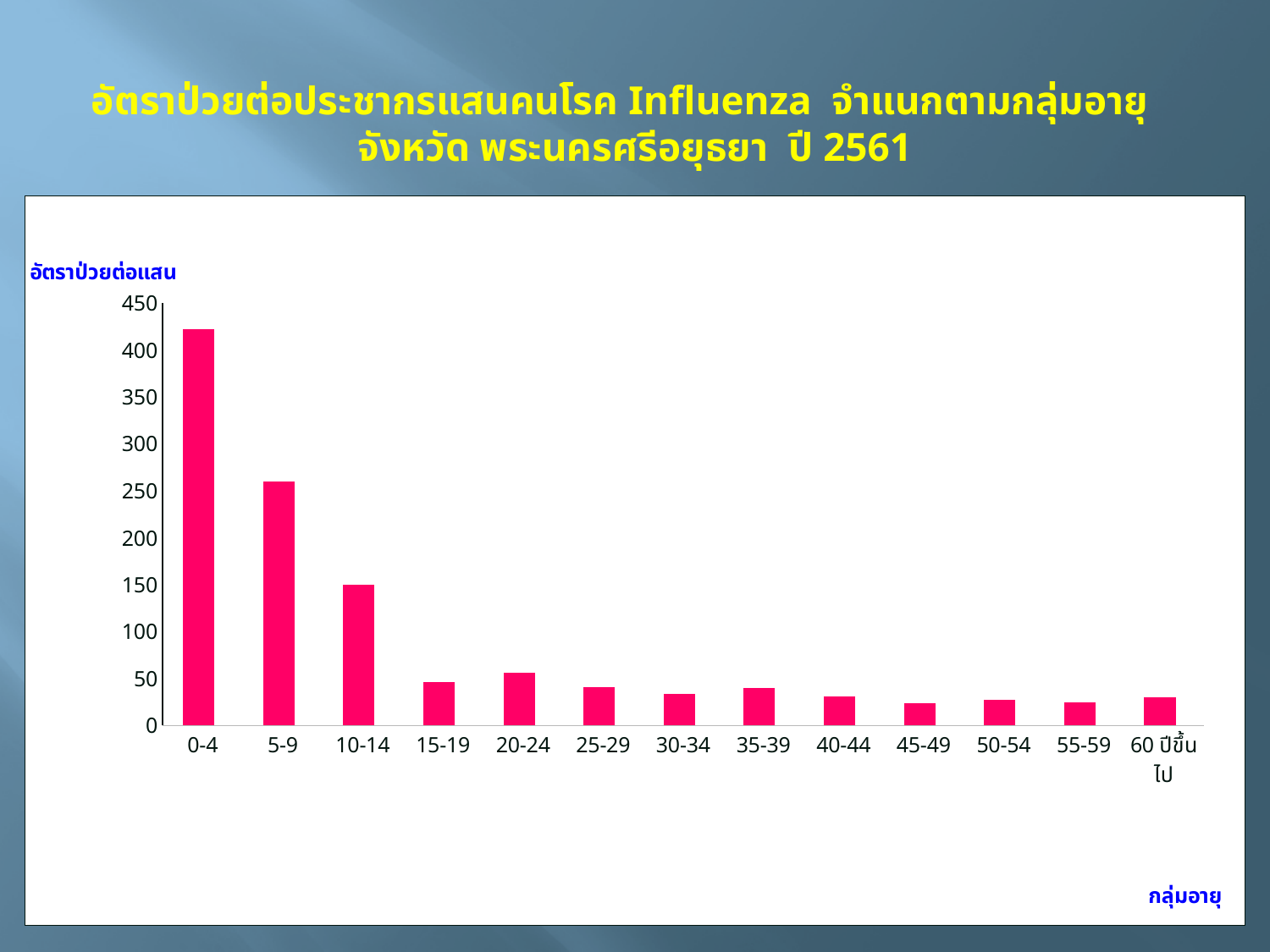
Which has the larger value, the 20-24 age group or the 30-34 age group? 20-24 Which age group has the highest rate? 0-4 Is the value for the 45-49 age group greater or less than 50? less Is the value for the 5-9 age group greater or less than 250? greater What colour are the bars in the chart? pink Which has the larger value, the 5-9 age group or the 10-14 age group? 5-9 Is the value for the 10-14 age group greater or less than 100? greater How many age-group categories are plotted on the x axis? 13 What kind of chart is shown on the slide? bar chart Do the values generally rise or fall as the age groups increase along the x axis? fall